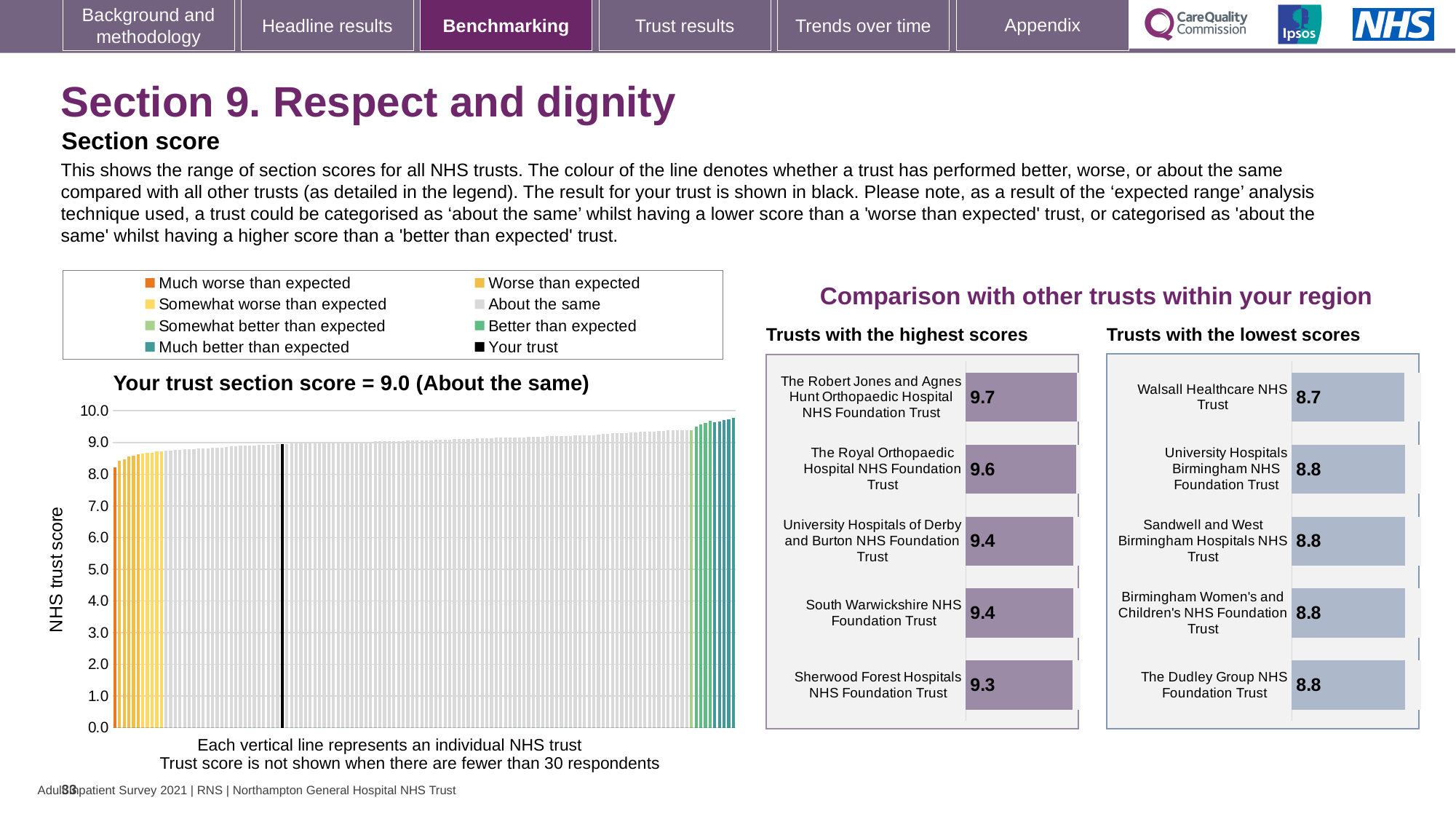
In the 'Trusts with the highest scores' chart, what is the score for The Robert Jones and Agnes Hunt Orthopaedic Hospital NHS Foundation Trust? 9.7 What kind of chart is the 'Your trust section score' chart on the left? Bar chart In the 'Trusts with the highest scores' chart, what is the difference between the scores of The Robert Jones and Agnes Hunt Orthopaedic Hospital NHS Foundation Trust and Sherwood Forest Hospitals NHS Foundation Trust? 0.4 In the 'Trusts with the highest scores' chart, which trust has the highest score? The Robert Jones and Agnes Hunt Orthopaedic Hospital NHS Foundation Trust In the 'Trusts with the highest scores' chart, what is the score for Sherwood Forest Hospitals NHS Foundation Trust? 9.3 In the 'Your trust section score' chart on the left, what is the section score for your trust? 9.0 Which has a higher score: The Royal Orthopaedic Hospital NHS Foundation Trust in the highest scores chart, or University Hospitals Birmingham NHS Foundation Trust in the lowest scores chart? The Royal Orthopaedic Hospital NHS Foundation Trust In the 'Trusts with the highest scores' chart, how many trusts are listed? 5 In the 'Trusts with the lowest scores' chart, which trust has the lowest score? Walsall Healthcare NHS Trust In the 'Trusts with the lowest scores' chart, what is the difference between the scores of The Dudley Group NHS Foundation Trust and Walsall Healthcare NHS Trust? 0.1 In the 'Your trust section score' chart on the left, do the trust scores rise or fall from left to right? Rise In the 'Trusts with the lowest scores' chart, what is the score for Walsall Healthcare NHS Trust? 8.7